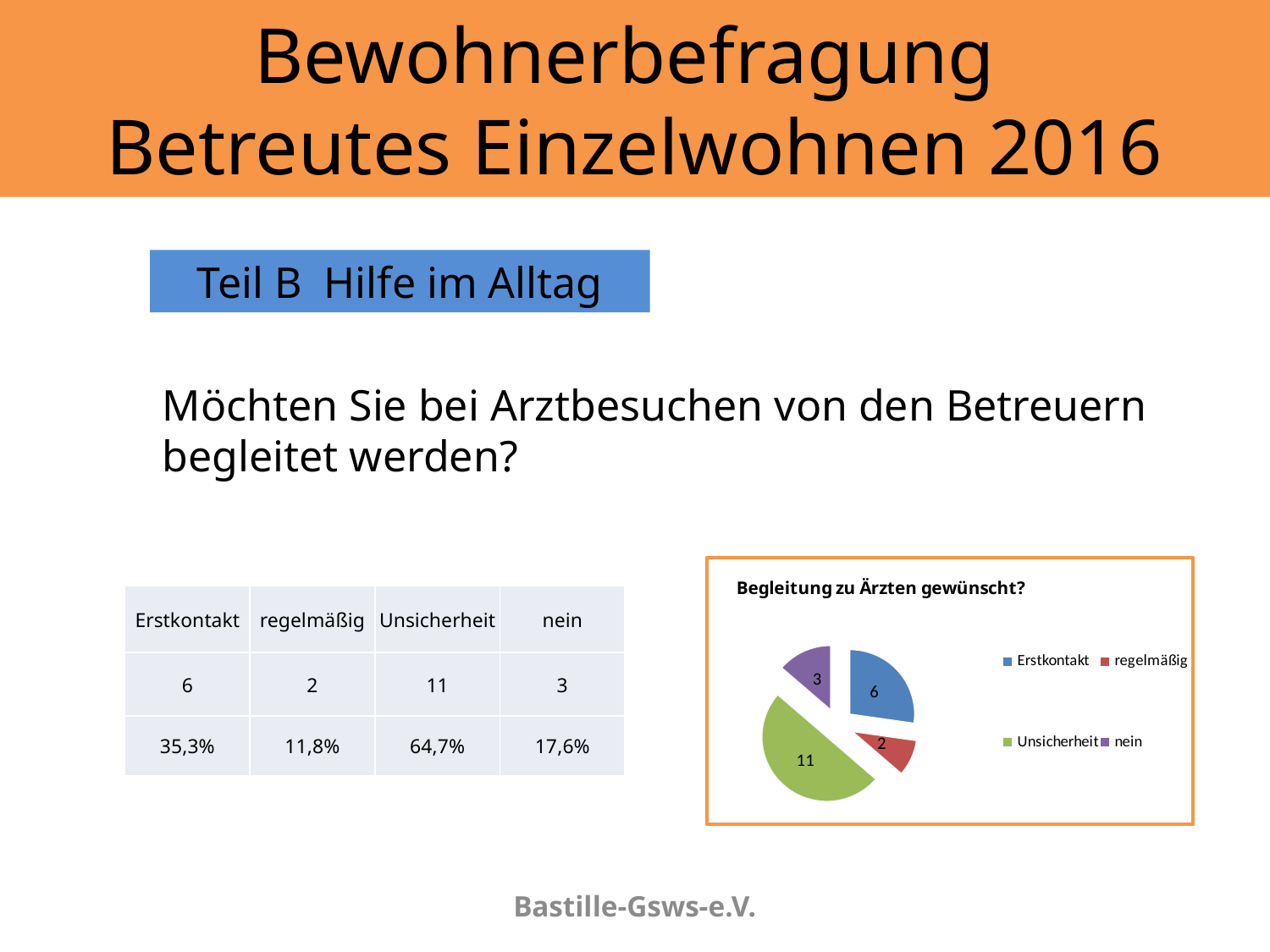
What is the title of the chart? Begleitung zu Ärzten gewünscht? What is the value of the Unsicherheit slice in the pie chart? 11 What is the difference between the Unsicherheit and Erstkontakt values in the pie chart? 5 What is the value of the nein slice in the pie chart? 3 What is the value of the Erstkontakt slice in the pie chart? 6 How many entries does the chart legend list? 4 How many slices does the pie chart have? 4 What is the value of the regelmäßig slice in the pie chart? 2 Which is larger in the pie chart, nein or regelmäßig? nein What type of chart is shown on the slide? pie chart Which category has the smallest slice in the pie chart? regelmäßig Which category has the largest slice in the pie chart? Unsicherheit